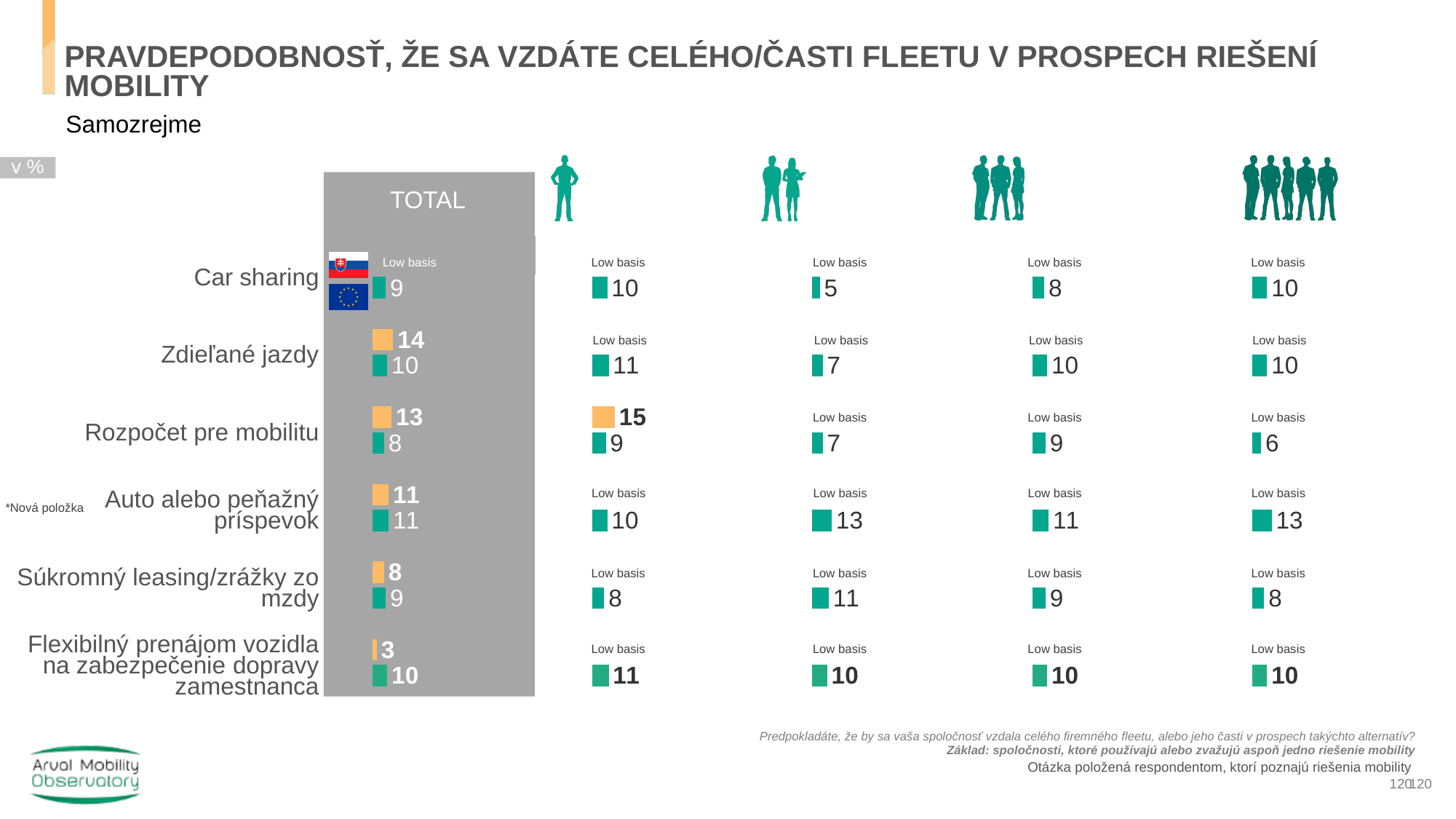
In the TOTAL column, what is the difference between the Slovakia and EU values for Rozpočet pre mobilitu? 5 What type of chart is used to display the values? Bar chart In the TOTAL column, which is larger for Súkromný leasing/zrážky zo mzdy: the Slovakia value or the EU value? EU value In the TOTAL column, what is the Slovakia (orange) value for Rozpočet pre mobilitu? 13 In the TOTAL column, what is the EU value for Zdieľané jazdy? 10 In the first company-size column (single-person icon), what is the orange value for Rozpočet pre mobilitu? 15 In the fourth company-size column (five-person icon), what is the value for Auto alebo peňažný príspevok? 13 In the TOTAL column, which category has the highest Slovakia (orange) value? Zdieľané jazdy In the second company-size column (two-person icon), what is the value for Car sharing? 5 How many categories (rows) are shown in the chart? 6 In the TOTAL column, what is the Slovakia (orange) value for Flexibilný prenájom vozidla na zabezpečenie dopravy zamestnanca? 3 In the TOTAL column, which category has the lowest Slovakia (orange) value? Flexibilný prenájom vozidla na zabezpečenie dopravy zamestnanca